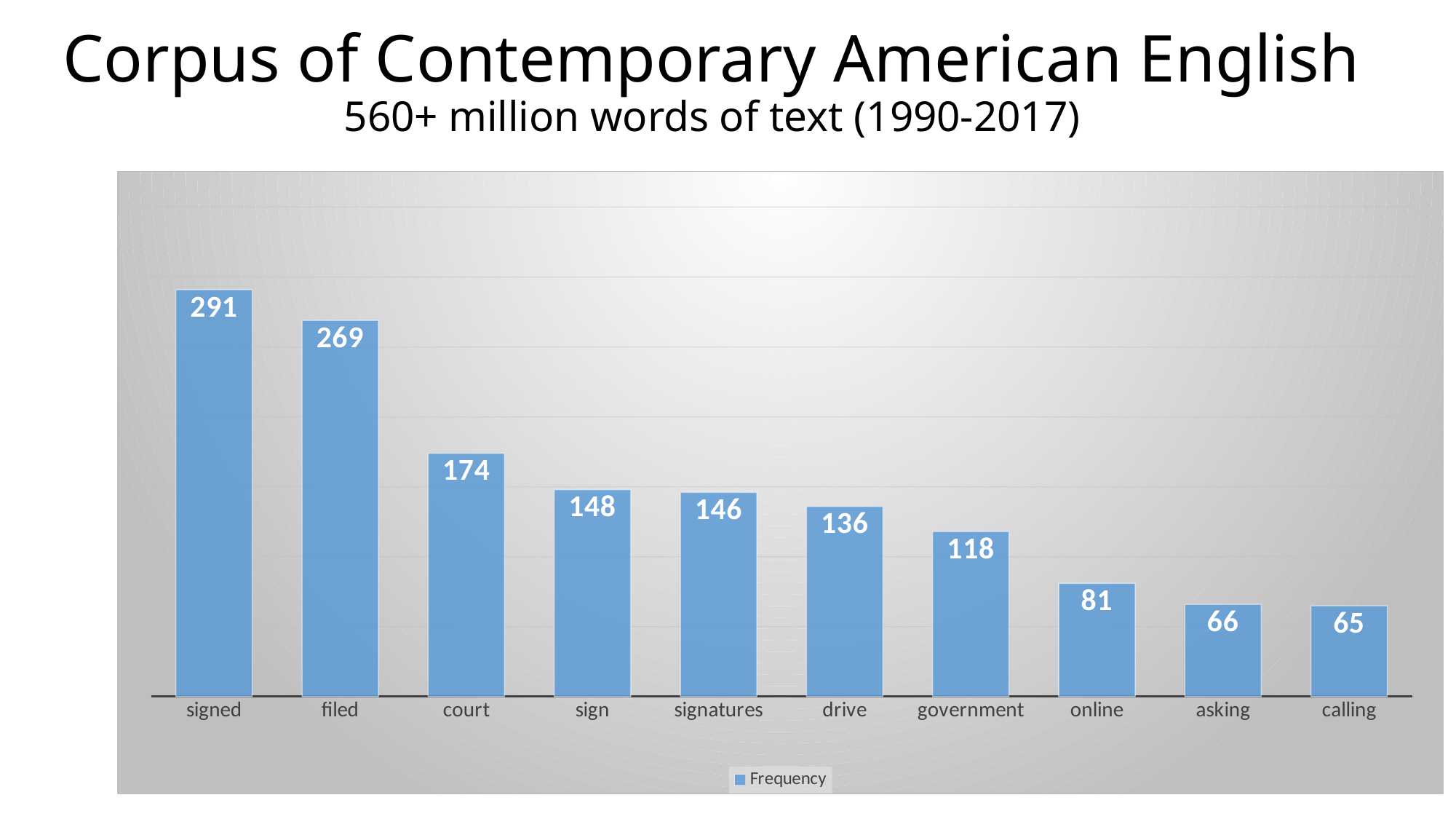
Which word has the highest frequency? signed What kind of chart is shown on the slide? bar chart How many words are shown on the x axis? 10 Do the values rise or fall from left to right along the x axis? fall How many series does the legend list? 1 What is the difference between the frequency of "court" and "drive"? 38 What is the frequency value for "online"? 81 What is the frequency value for "court"? 174 What is the frequency value for "government"? 118 Which word has the lowest frequency? calling What is the difference between the frequency of "signed" and "filed"? 22 Which has a higher frequency, "sign" or "drive"? sign